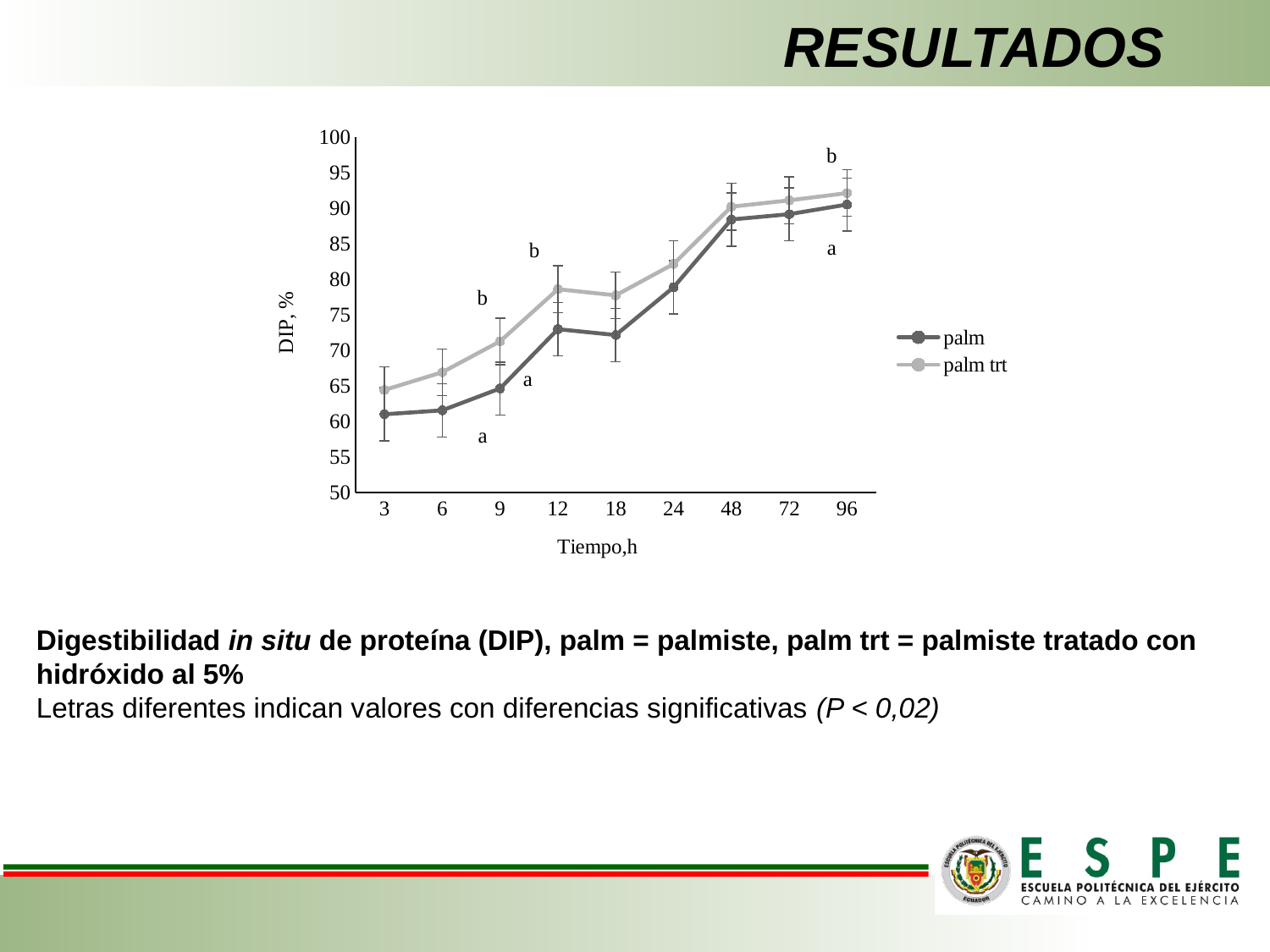
Do the DIP values for palm generally rise or fall as time increases? rise Is the DIP value for palm trt at 96 h greater or less than 90? greater At which time point does the palm trt series have its lowest DIP value? 3 How many series does the legend list? 2 At 12 h, which series has the higher DIP value, palm or palm trt? palm trt Is the DIP value for palm at 3 h greater or less than 65? less What is the label of the y axis? DIP, % What type of chart is shown on the slide? line chart Is the DIP value for palm at 48 h greater or less than 90? less At which time point does the palm series reach its highest DIP value? 96 How many time points are plotted along the x axis? 9 What is the label of the x axis? Tiempo,h